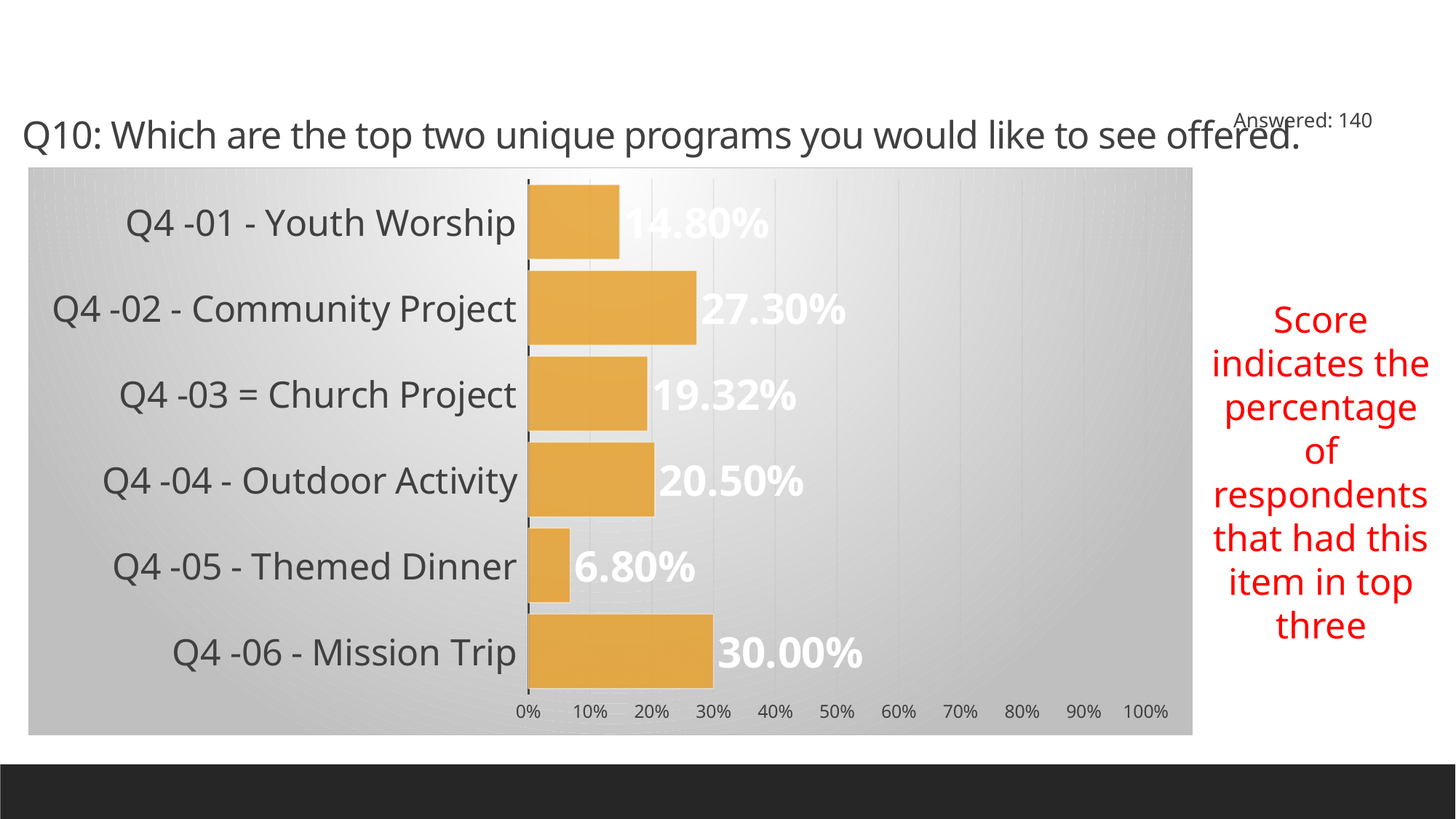
Which is larger, the value for Q4 -04 - Outdoor Activity or Q4 -03 = Church Project? Q4 -04 - Outdoor Activity How many categories are shown in the chart? 6 What kind of chart is shown on the slide? bar chart What is the value for Q4 -03 = Church Project? 19.32% Is the value for Q4 -02 - Community Project greater or less than 20%? greater What is the difference between the values for Q4 -02 - Community Project and Q4 -01 - Youth Worship? 12.50% What is the value for Q4 -06 - Mission Trip? 30.00% What is the value for Q4 -01 - Youth Worship? 14.80% What is the difference between the values for Q4 -06 - Mission Trip and Q4 -05 - Themed Dinner? 23.20% How many respondents answered the question, according to the slide? 140 Which category has the highest value? Q4 -06 - Mission Trip Which category has the lowest value? Q4 -05 - Themed Dinner